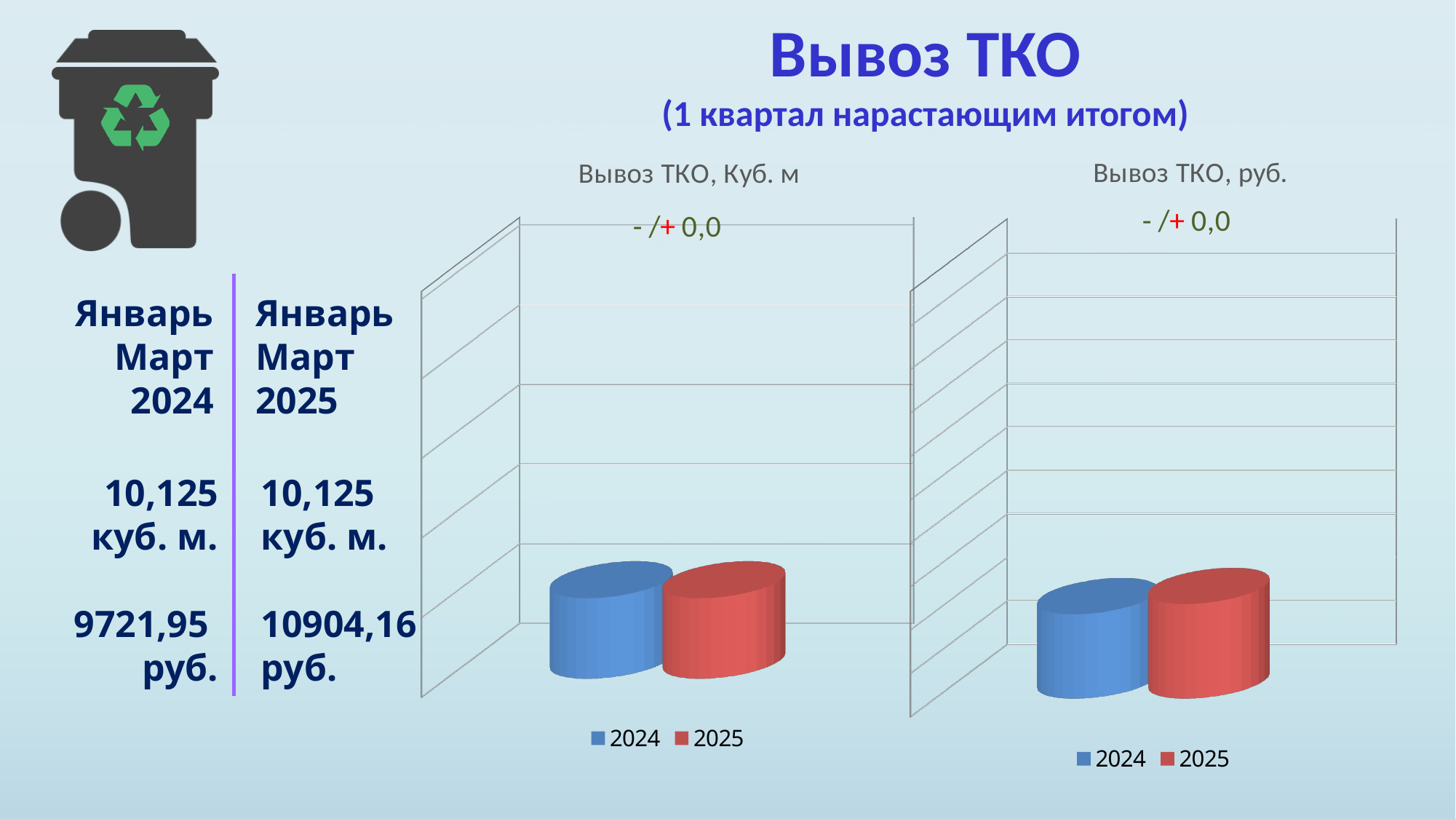
In the chart titled "Вывоз ТКО, руб.", which is larger, the bar for 2024 or the bar for 2025? 2025 In the chart titled "Вывоз ТКО, руб.", how many series does the legend list? 2 In the chart titled "Вывоз ТКО, Куб. м", how many bars are plotted? 2 In the chart titled "Вывоз ТКО, Куб. м", how many series does the legend list? 2 In the chart titled "Вывоз ТКО, руб.", what colour is the bar for 2024? blue In the chart titled "Вывоз ТКО, руб.", which series has the tallest bar? 2025 What kind of chart is the chart titled "Вывоз ТКО, Куб. м"? bar chart What are the legend entries of the chart titled "Вывоз ТКО, Куб. м"? 2024, 2025 In the chart titled "Вывоз ТКО, руб.", how many bars are plotted? 2 In the chart titled "Вывоз ТКО, руб.", which series has the shortest bar? 2024 What kind of chart is the chart titled "Вывоз ТКО, руб."? bar chart